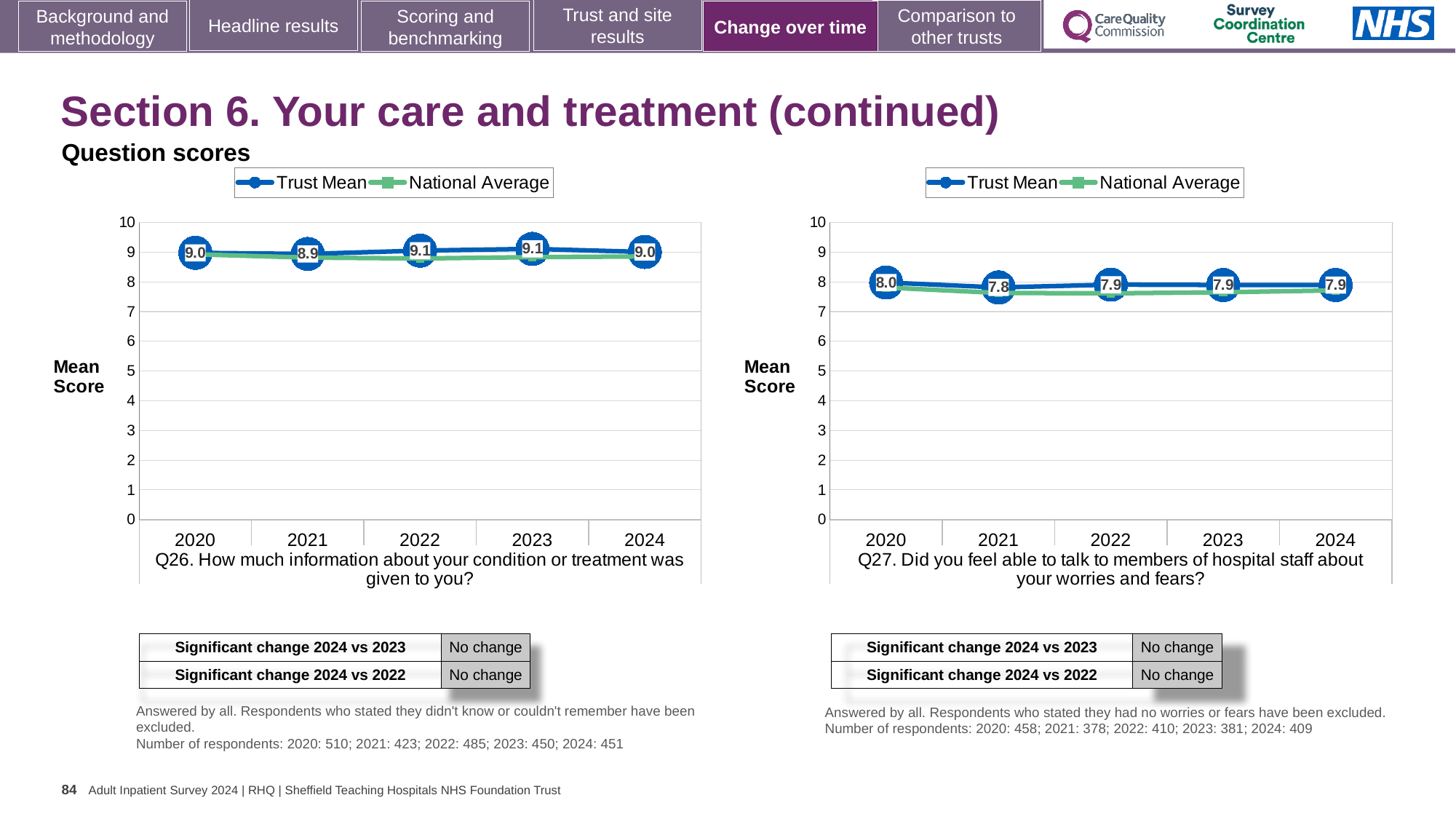
In the Q26 chart (left), what is the Trust Mean score for 2021? 8.9 In the Q27 chart (right), is the National Average value for 2021 greater or less than 8? less In the Q26 chart (left), what is the Trust Mean score for 2022? 9.1 In the Q27 chart (right), which year has the lowest Trust Mean score? 2021 In the Q27 chart (right), which year has the highest Trust Mean score? 2020 In the Q26 chart (left), which year has the lowest Trust Mean score? 2021 In the Q27 chart (right), is the Trust Mean score higher in 2020 or 2021? 2020 In the Q26 chart (left), what is the difference between the Trust Mean scores for 2023 and 2021? 0.2 How many series does the legend of the Q27 chart (right) list? 2 How many years are plotted on the x axis of the Q26 chart (left)? 5 In the Q27 chart (right), what is the Trust Mean score for 2020? 8.0 In the Q27 chart (right), what is the Trust Mean score for 2024? 7.9